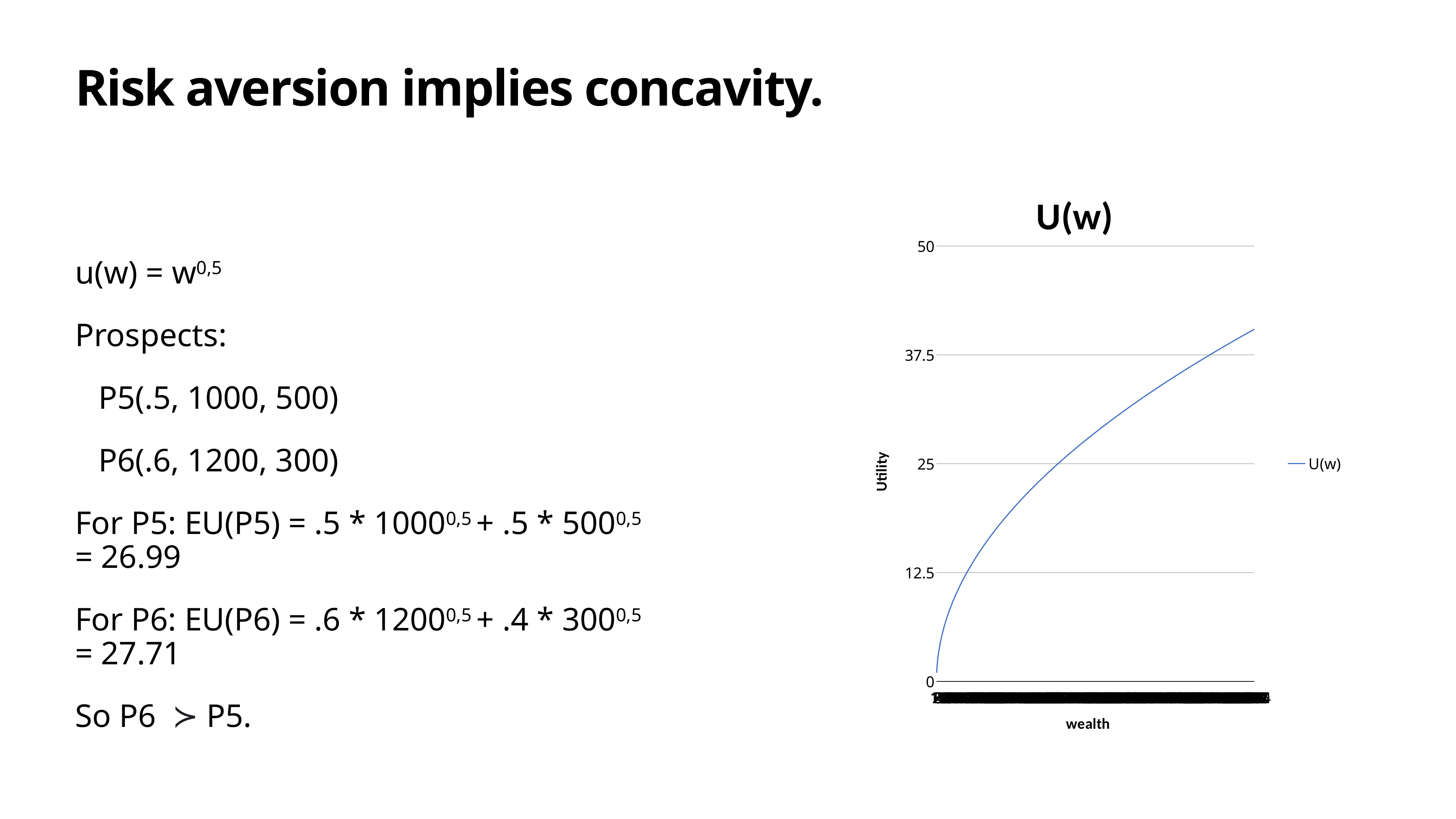
Does the U(w) line rise or fall as wealth increases along the x axis? rise How many series does the chart's legend list? 1 What kind of chart is shown on the slide? line chart What is the title of the chart? U(w) What is the label of the vertical axis of the chart? Utility What is the highest tick value shown on the vertical axis of the chart? 50 Is the highest point of the U(w) line greater or less than 37.5? greater Is the highest point of the U(w) line greater or less than 50? less Is the lowest point of the U(w) line greater or less than 12.5? less